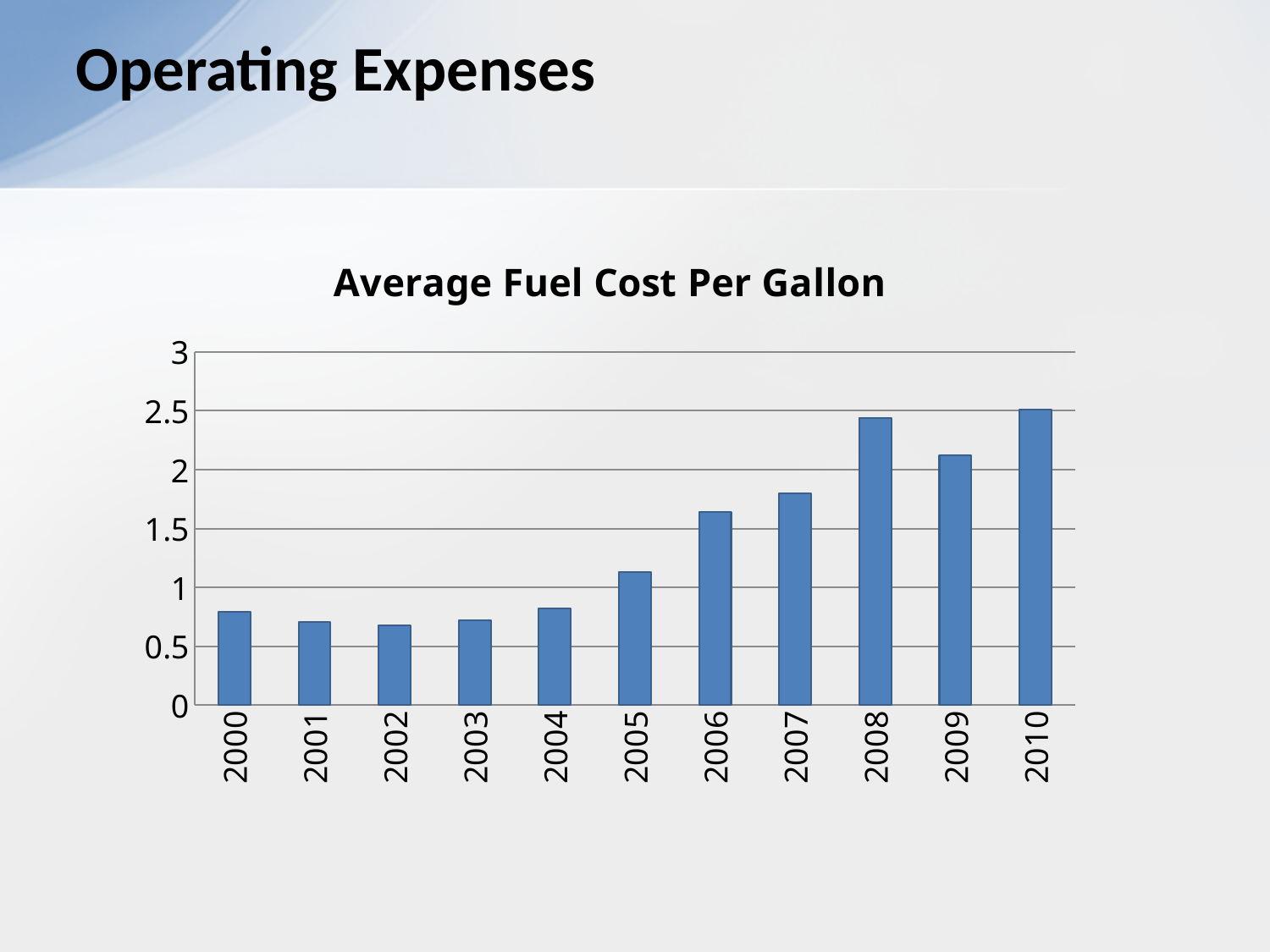
Is the value for 2002 greater or less than 1? less What is the highest value shown on the vertical axis? 3 Overall, do the values rise or fall from 2000 to 2010? rise Is the value for 2008 greater or less than 2? greater What is the title of the chart? Average Fuel Cost Per Gallon Is the value for 2005 greater or less than 1? greater Which year has the higher value, 2004 or 2005? 2005 How many years are plotted on the chart? 11 Which year has the higher value, 2008 or 2009? 2008 What type of chart is shown on the slide? bar chart